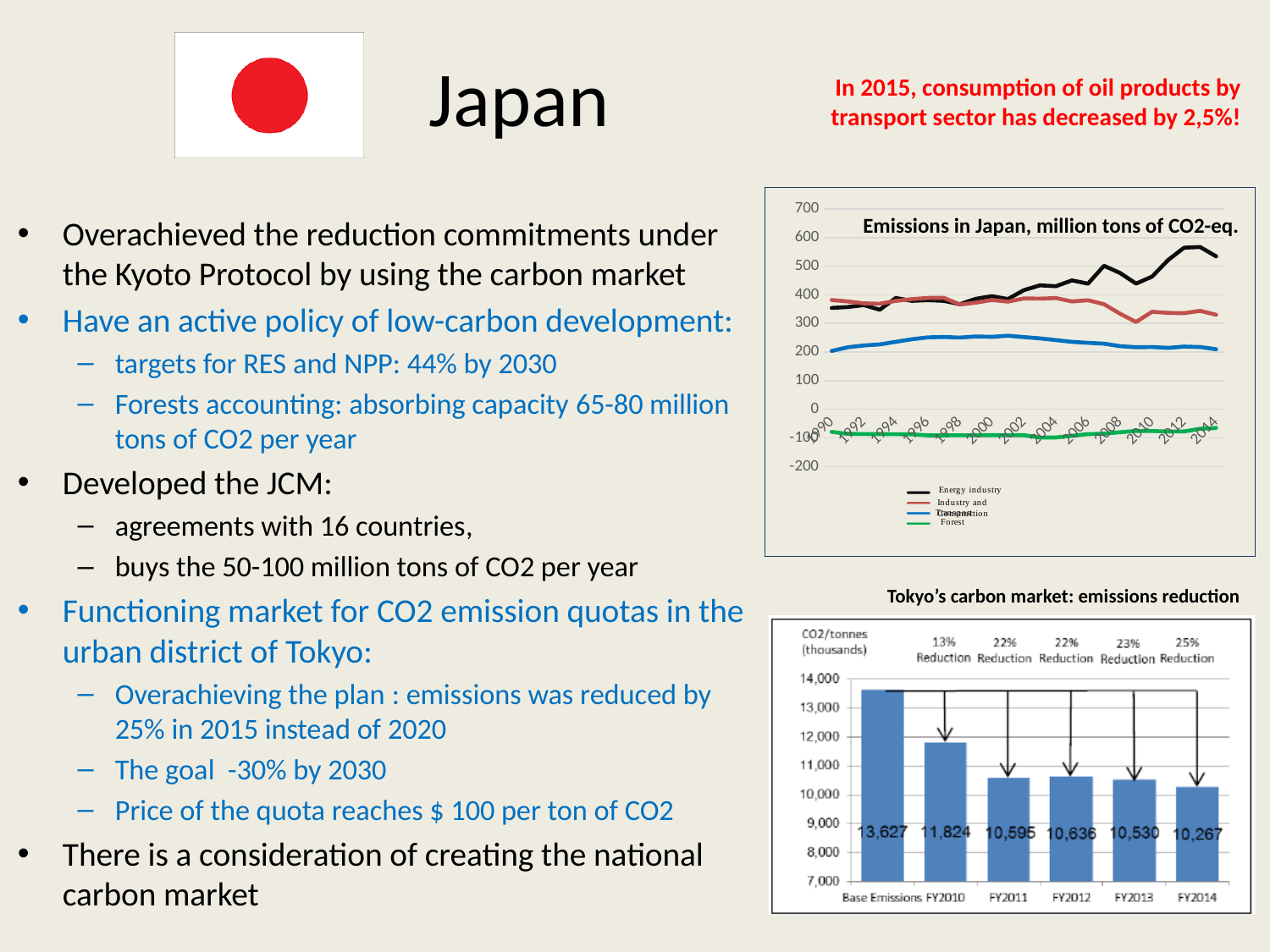
In the Emissions in Japan chart, is the value for Energy industry in 2012 greater or less than 500? greater In the Tokyo's carbon market chart, what is the value for Base Emissions? 13,627 In the Tokyo's carbon market chart, which category has the lowest value? FY2014 In the Tokyo's carbon market chart, what is the difference between Base Emissions and FY2014? 3,360 In the Tokyo's carbon market chart, what is the value for FY2010? 11,824 In the Tokyo's carbon market chart, which category has the highest value? Base Emissions In the Tokyo's carbon market chart, how many bars are plotted? 6 What kind of chart is the Emissions in Japan chart? Line chart What kind of chart is the Tokyo's carbon market chart? Bar chart In the Tokyo's carbon market chart, what is the value for FY2014? 10,267 In the Emissions in Japan chart, how many series does the legend list? 4 In the Tokyo's carbon market chart, which is larger, FY2013 or FY2010? FY2010